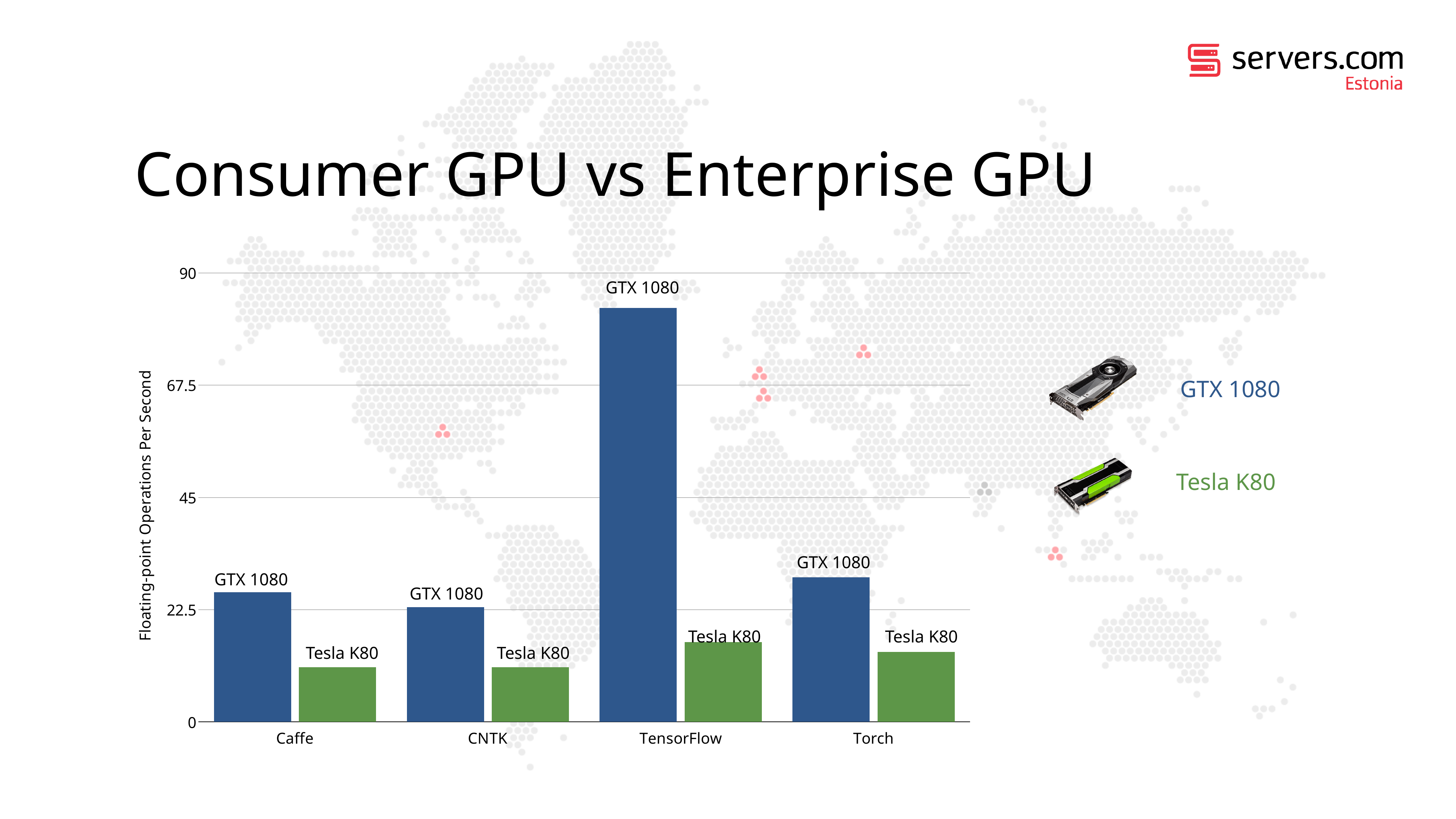
Is the GTX 1080 value for TensorFlow greater or less than 67.5? greater How many frameworks (categories) are shown along the x axis of the chart? 4 What is the label of the vertical axis of the chart? Floating-point Operations Per Second What kind of chart is shown on the slide? bar chart Is the GTX 1080 value for CNTK greater or less than 45? less Is the Tesla K80 value for Caffe greater or less than 22.5? less Which GPU is shown in green in the chart? Tesla K80 How many GPU series does the chart compare? 2 For which framework is the GTX 1080 bar the highest? TensorFlow For which framework is the Tesla K80 bar the highest? TensorFlow For Torch, which GPU has the larger value, GTX 1080 or Tesla K80? GTX 1080